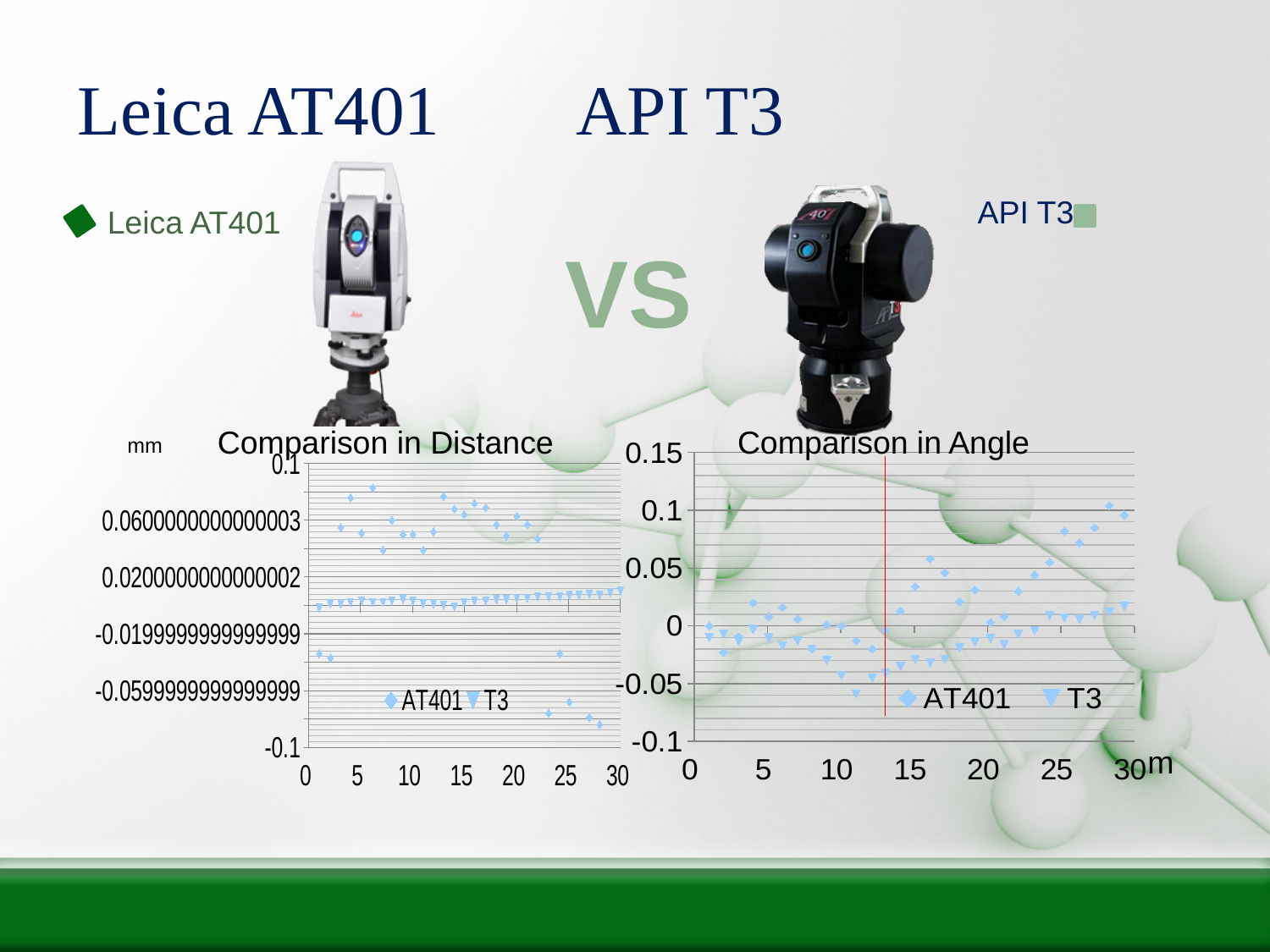
What is the highest value shown on the vertical axis of the Comparison in Angle chart? 0.15 What kind of chart is the Comparison in Angle chart? scatter chart In the Comparison in Distance chart, which series shows the larger spread of values, AT401 or T3? AT401 In the Comparison in Angle chart, is the AT401 value at about 28 on the x axis greater or less than 0.05? greater What are the two series named in the legend of the Comparison in Angle chart? AT401 and T3 How many series does the legend of the Comparison in Angle chart list? 2 In the Comparison in Distance chart, are the T3 values greater or less than 0.02? less How many series does the legend of the Comparison in Distance chart list? 2 In the Comparison in Angle chart, is the T3 value at about 11 on the x axis greater or less than 0? less What kind of chart is the Comparison in Distance chart? scatter chart What is the largest value shown on the horizontal axis of the Comparison in Distance chart? 30